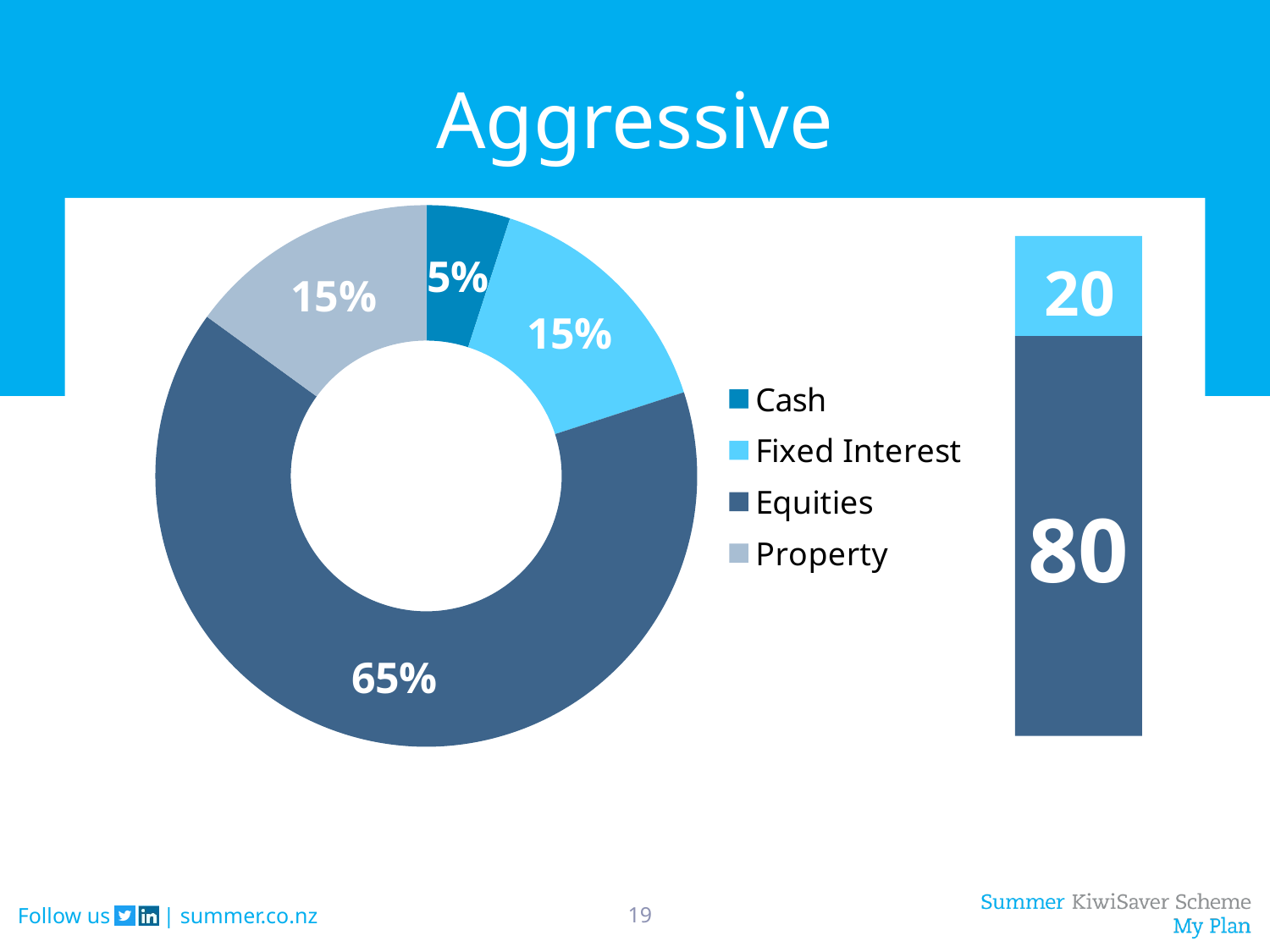
What kind of chart is shown on the left of the slide? Doughnut chart On the stacked bar on the right of the slide, what value is shown in the dark blue segment? 80 On the doughnut chart on the left, which is larger, the share for Cash or the share for Fixed Interest? Fixed Interest On the doughnut chart on the left, what percentage is shown for Fixed Interest? 15% How many categories does the legend of the doughnut chart on the left list? 4 On the doughnut chart on the left, which category has the smallest share? Cash On the doughnut chart on the left, what percentage is shown for Equities? 65% What is the title of the slide containing the doughnut chart? Aggressive On the doughnut chart on the left, what percentage is shown for Cash? 5% On the doughnut chart on the left, which category has the largest share? Equities On the doughnut chart on the left, what is the difference in percentage points between Equities and Property? 50 On the stacked bar on the right of the slide, what is the total of the two segments? 100